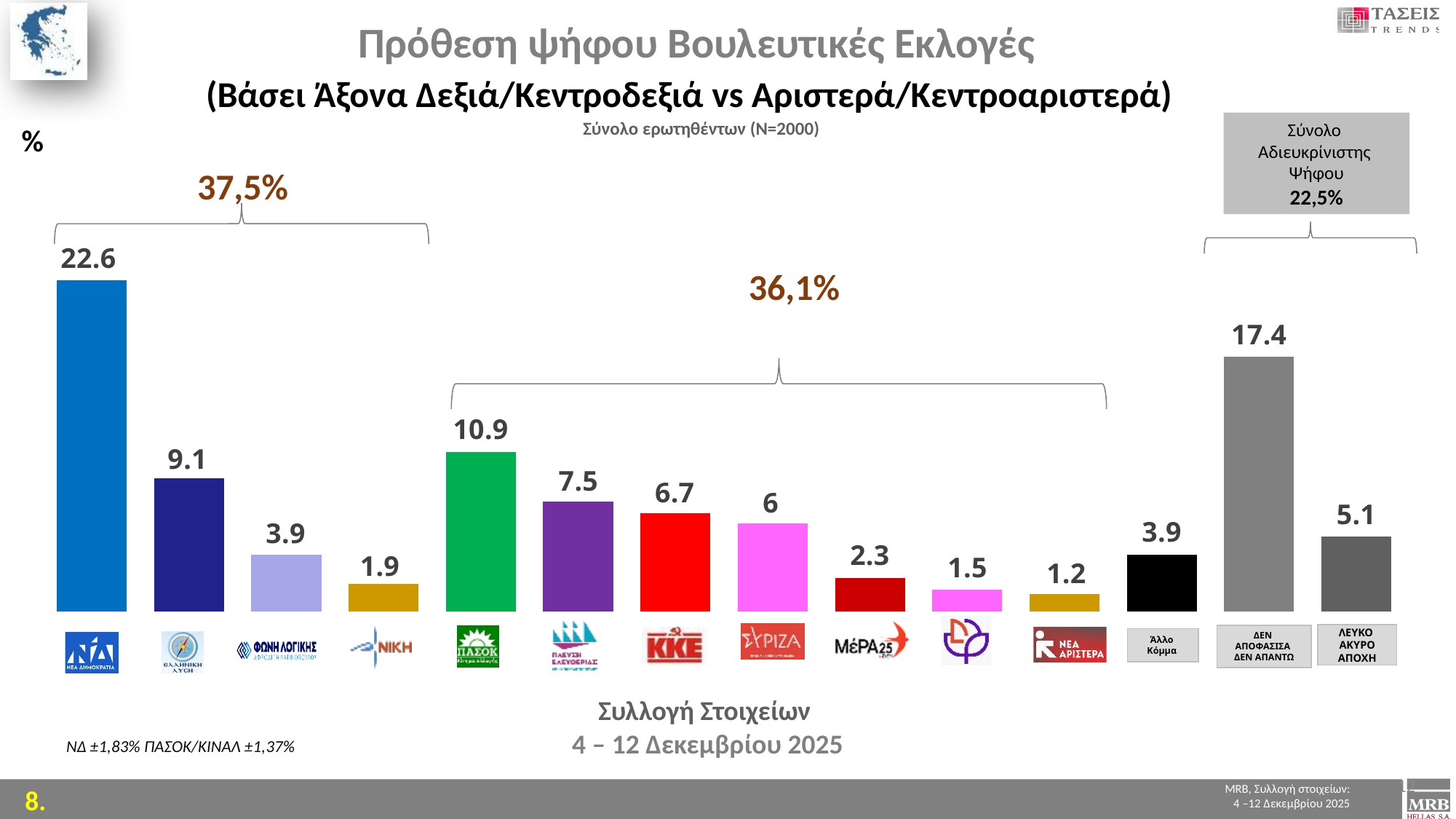
Which party has the highest value on the chart? ΝΔ (Νέα Δημοκρατία) Which bar has the lowest value on the chart? ΝΕΑ ΑΡΙΣΤΕΡΑ (1.2) What is the value shown for ΚΚΕ? 6.7 What is the difference between the values for ΝΔ and ΠΑΣΟΚ? 11.7 How many bars are plotted on the chart? 14 What kind of chart is shown on the slide? Bar chart Which is larger, the value for ΣΥΡΙΖΑ or the value for ΚΚΕ? ΚΚΕ What is the value shown for the ΔΕΝ ΑΠΟΦΑΣΙΣΑ / ΔΕΝ ΑΠΑΝΤΩ bar? 17.4 What is the Σύνολο Αδιευκρίνιστης Ψήφου value shown in the grey box? 22,5% What is the value shown for ΠΑΣΟΚ? 10.9 What total is shown by the bracket over the Δεξιά/Κεντροδεξιά group (ΝΔ to ΝΙΚΗ)? 37,5% What is the value shown for ΝΔ (Νέα Δημοκρατία)? 22.6